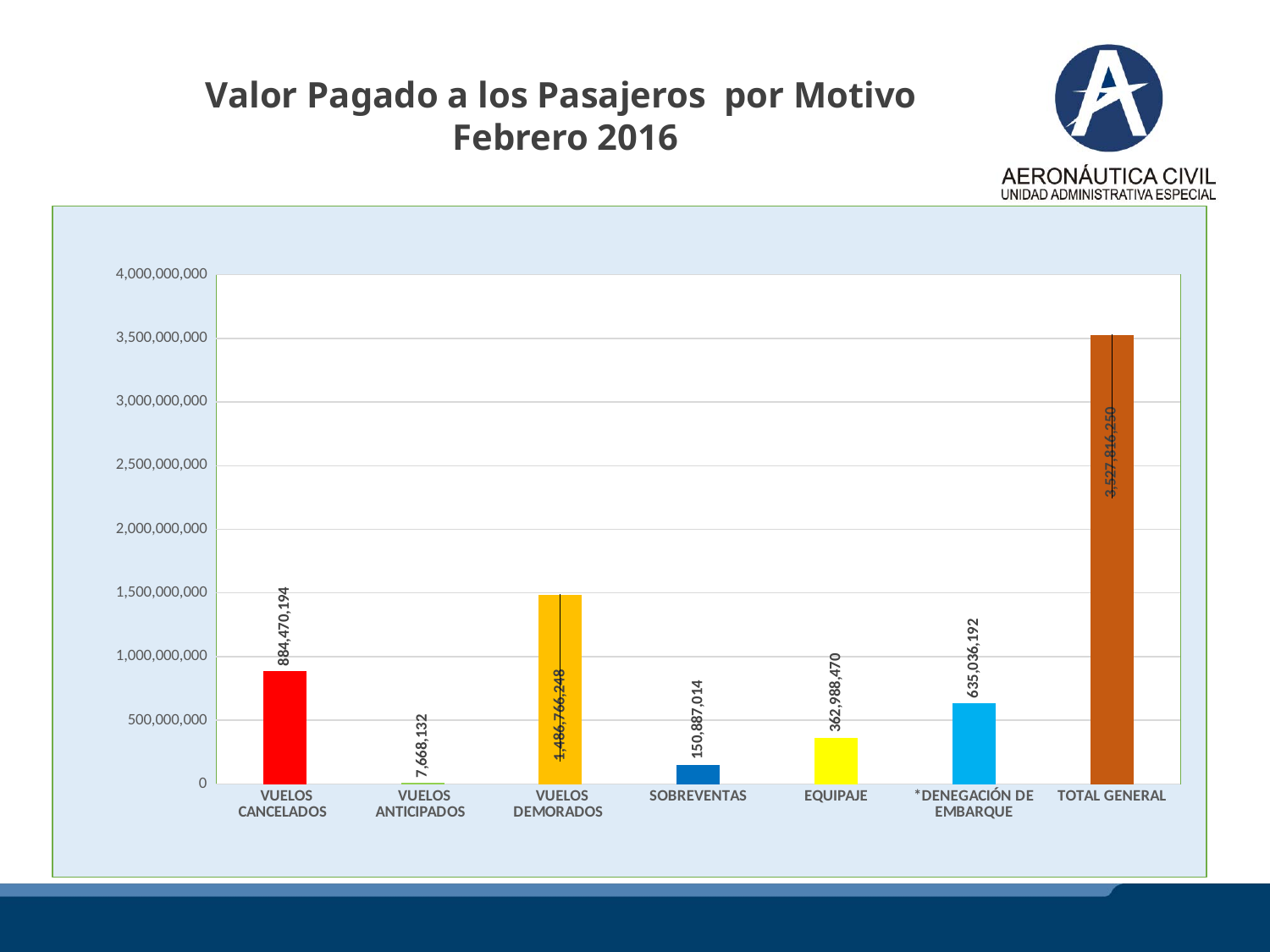
What value is shown for *DENEGACIÓN DE EMBARQUE? 635,036,192 What is the value of the TOTAL GENERAL bar? 3,527,816,250 How many categories are shown on the x axis? 7 Excluding TOTAL GENERAL, which category has the highest value? VUELOS DEMORADOS What type of chart is shown on the slide? Bar chart Is the value for VUELOS DEMORADOS greater or less than 1,000,000,000? greater What value is shown for SOBREVENTAS? 150,887,014 What is the difference between the values for VUELOS CANCELADOS and *DENEGACIÓN DE EMBARQUE? 249,434,002 What value is shown for VUELOS CANCELADOS? 884,470,194 Which category has the lowest value? VUELOS ANTICIPADOS Which is larger, the value for EQUIPAJE or the value for SOBREVENTAS? EQUIPAJE What value is shown for VUELOS DEMORADOS? 1,486,766,248